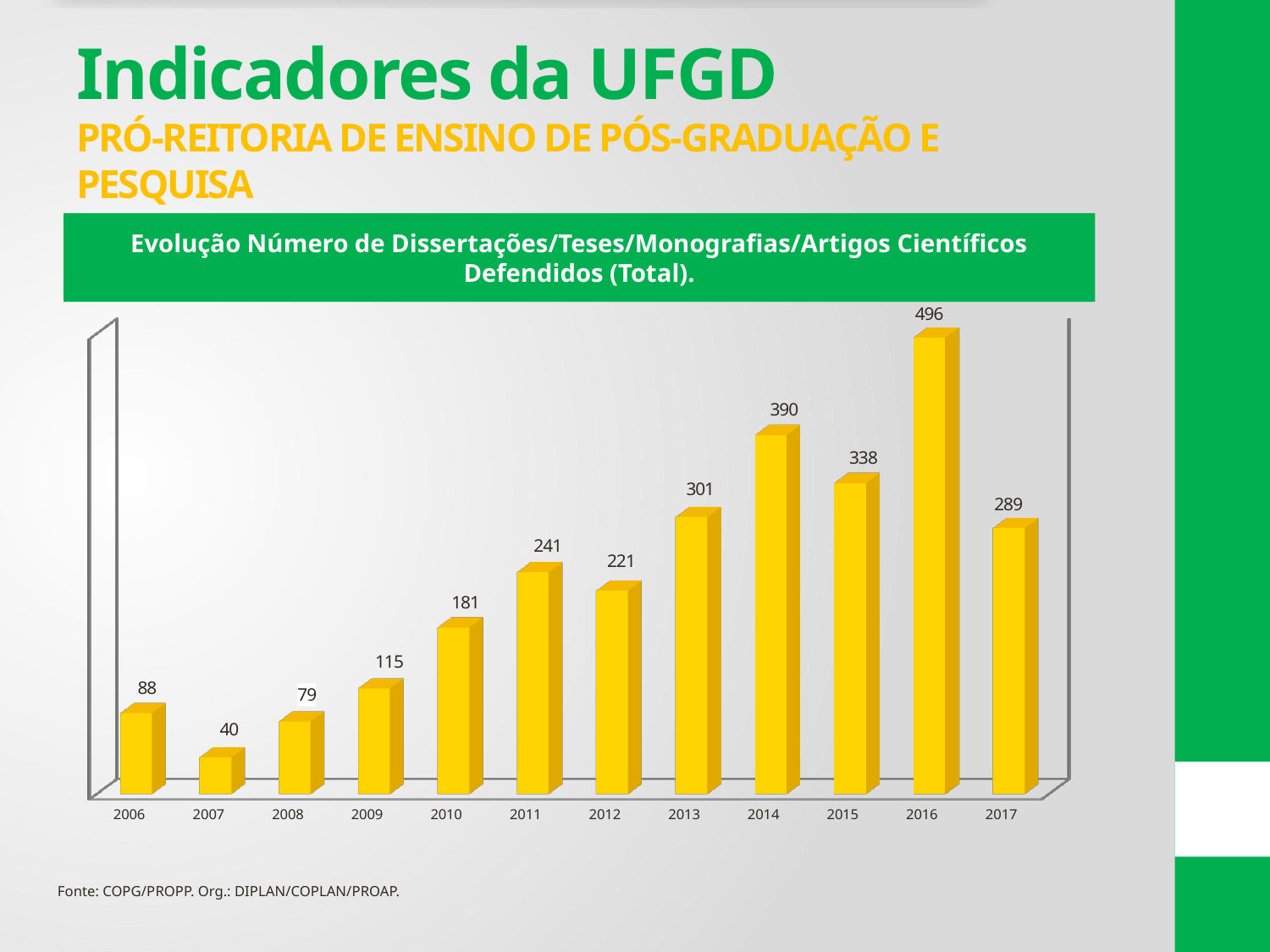
Which year has the highest value? 2016 Do the values generally rise or fall from 2007 to 2016? Rise Which is larger, the value for 2014 or the value for 2015? 2014 What is the value for 2007? 40 What is the difference between the values for 2013 and 2012? 80 Which year has the lowest value? 2007 What kind of chart is this? Bar chart What is the value for 2016? 496 What is the title of the chart? Evolução Número de Dissertações/Teses/Monografias/Artigos Científicos Defendidos (Total). What is the difference between the values for 2016 and 2017? 207 What is the value for 2010? 181 How many years are shown on the x axis? 12